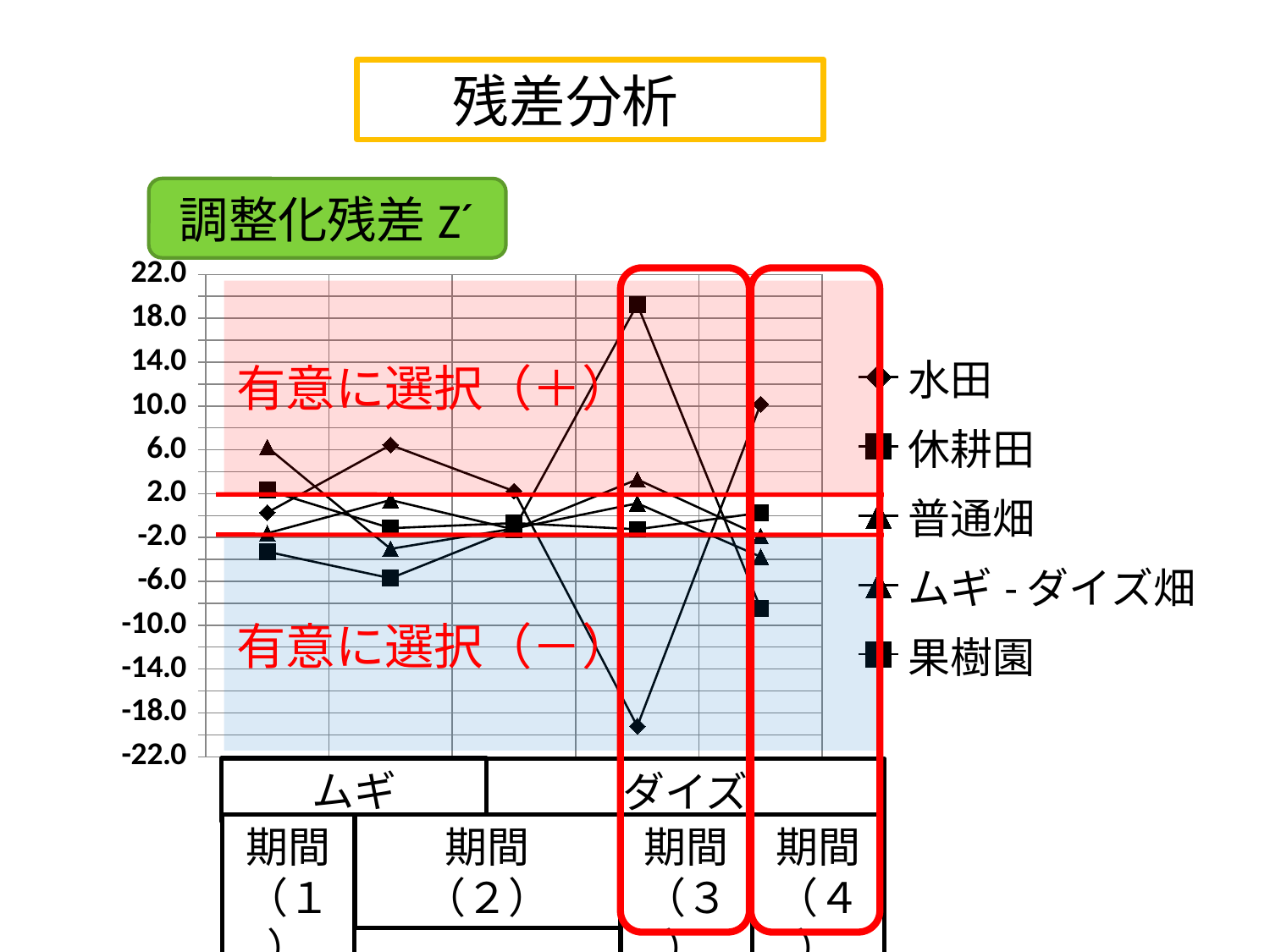
Which series has the highest value at 期間（1）? 普通畑 Which series has the highest value at 期間（3）? 休耕田 Is the value for 水田 at 期間（4） greater or less than 6.0? greater Is the value for 水田 at 期間（3） greater or less than -14.0? less Is the value for 休耕田 at 期間（3） greater or less than 14.0? greater What is the label in the green box above the chart? 調整化残差 Z′ Which series has the lowest value at 期間（3）? 水田 What kind of chart is shown on the slide? line chart Which series has the highest value at 期間（4）? 水田 How many series does the legend list? 5 Which series has the lowest value at 期間（4）? 休耕田